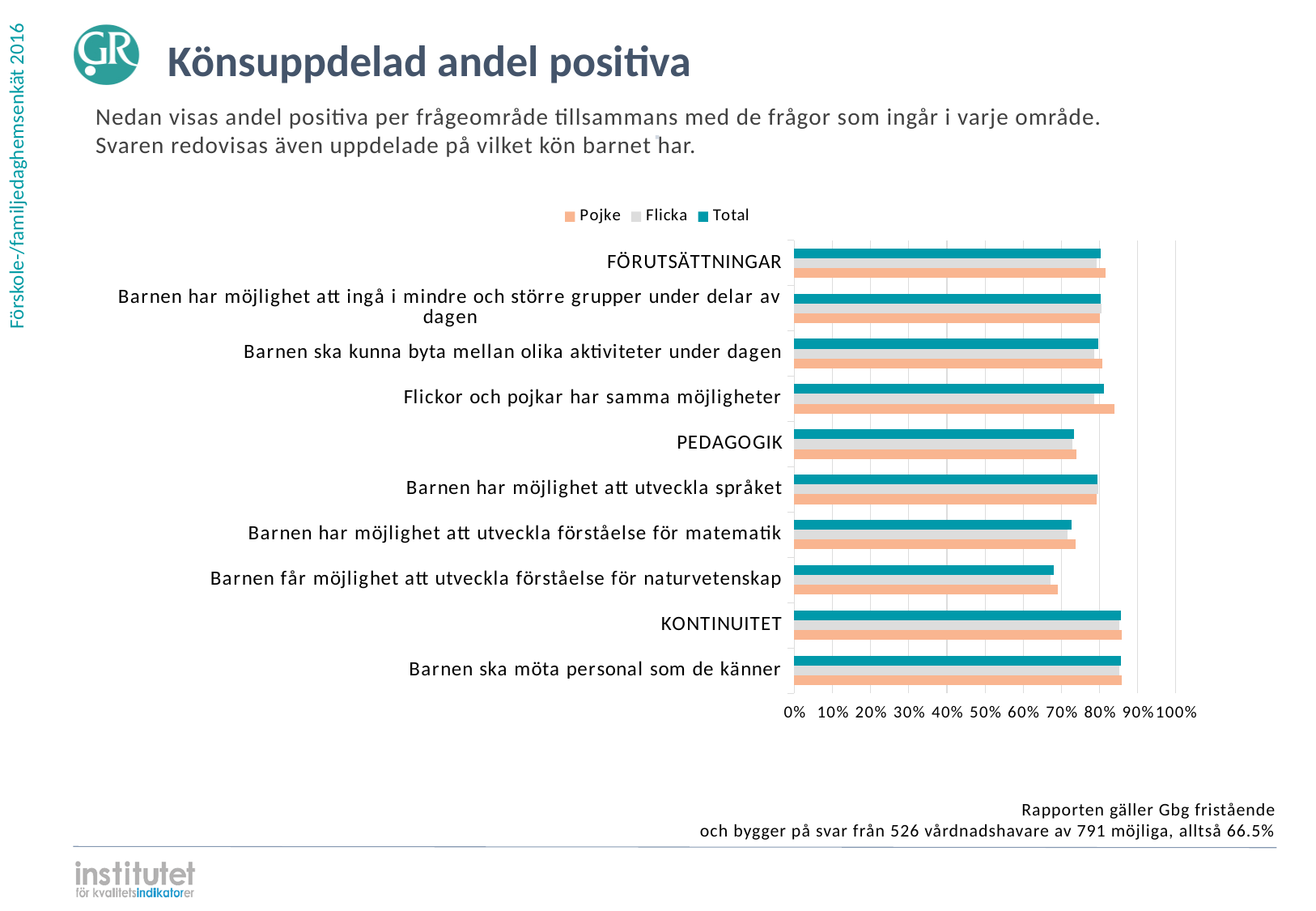
What is the title of the slide containing the chart? Könsuppdelad andel positiva For 'Flickor och pojkar har samma möjligheter', which is larger: the Pojke value or the Flicka value? Pojke Is the Total value for KONTINUITET greater or less than 80%? greater Which series are listed in the legend? Pojke, Flicka, Total Which is larger: the Total value for KONTINUITET or the Total value for PEDAGOGIK? KONTINUITET Which category has the lowest Total value? Barnen får möjlighet att utveckla förståelse för naturvetenskap Is the Pojke value for 'Flickor och pojkar har samma möjligheter' greater or less than 80%? greater Is the Total value for 'Barnen får möjlighet att utveckla förståelse för naturvetenskap' greater or less than 60%? greater How many categories are plotted on the chart? 10 How many series does the legend list? 3 What kind of chart is shown on the slide? bar chart